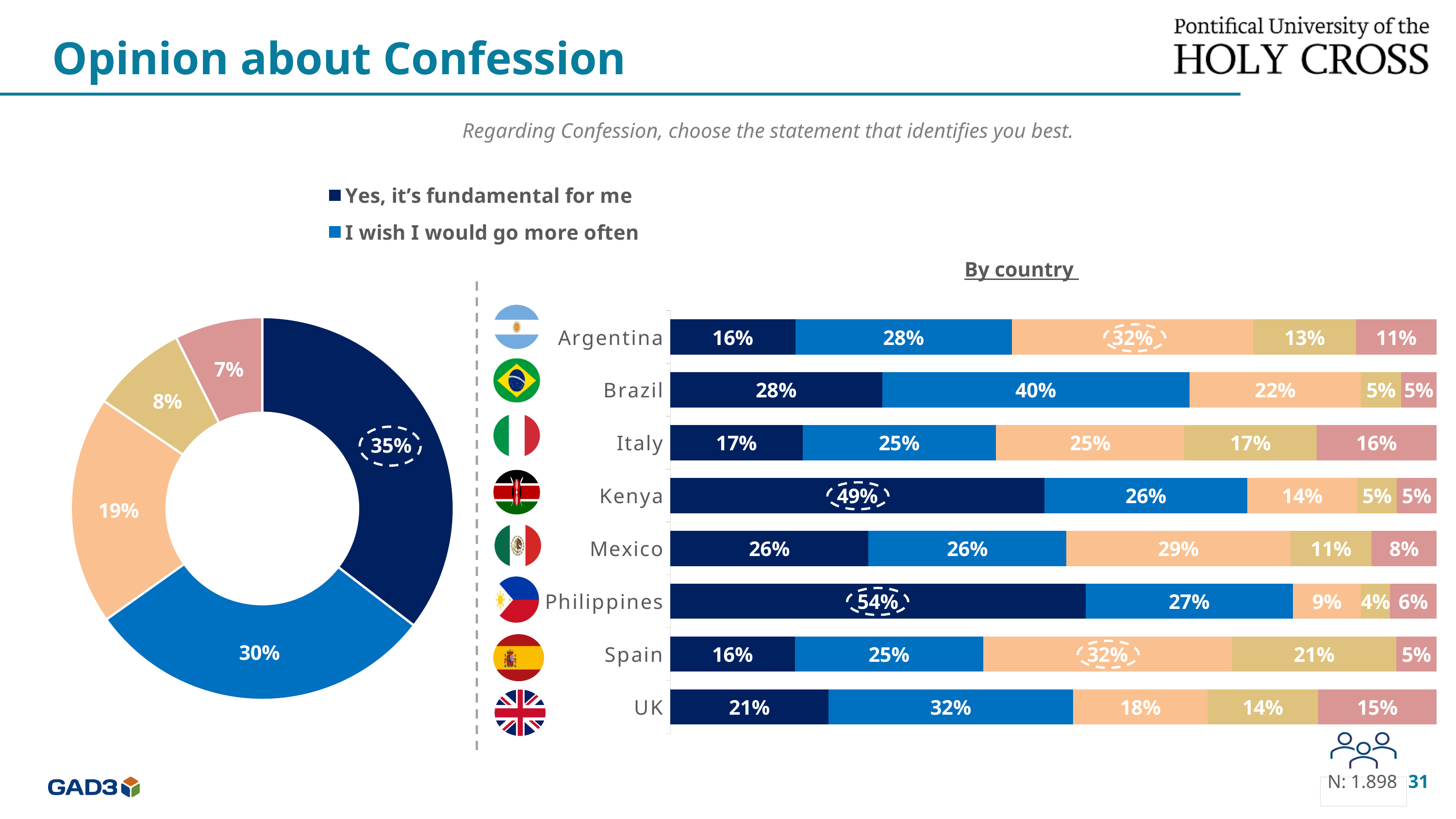
In the "By country" bar chart, what is the value for "I wish I would go more often" in the UK? 32% In the "By country" bar chart, which is larger for "I wish I would go more often": Brazil or the UK? Brazil What kind of chart is the "By country" chart on the right? Stacked horizontal bar chart In the "By country" bar chart, which country has the highest value for "Yes, it's fundamental for me"? Philippines What kind of chart is shown on the left of the slide? Donut chart In the "By country" bar chart, which country has the highest value for "I wish I would go more often"? Brazil In the "By country" bar chart, what is the value for "Yes, it's fundamental for me" in the Philippines? 54% In the "By country" bar chart, what is the difference between Kenya's and Argentina's values for "Yes, it's fundamental for me"? 33 percentage points In the donut chart on the left, what share of respondents chose "Yes, it's fundamental for me"? 35% How many countries are shown in the "By country" bar chart? 8 How many series does the legend on the slide list? 2 In the donut chart on the left, what share of respondents chose "I wish I would go more often"? 30%